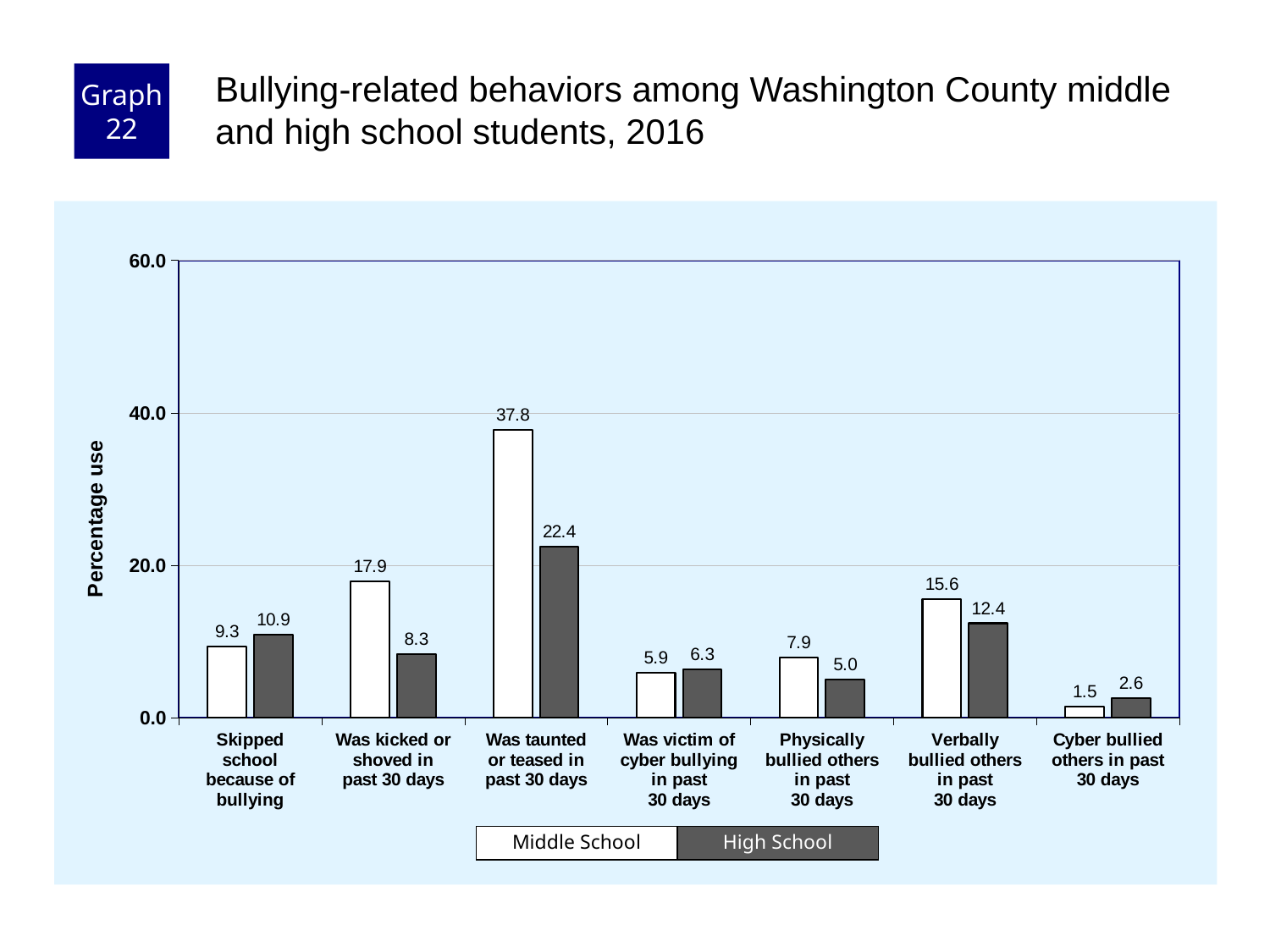
What is the High School value for 'Verbally bullied others in past 30 days'? 12.4 What is the Middle School value for 'Was taunted or teased in past 30 days'? 37.8 What is the difference between the Middle School and High School values for 'Was kicked or shoved in past 30 days'? 9.6 For 'Physically bullied others in past 30 days', which is larger: the Middle School or High School value? Middle School How many series does the legend list? 2 Which category has the highest Middle School value? Was taunted or teased in past 30 days Is the Middle School value for 'Was taunted or teased in past 30 days' greater or less than 40.0? less How many behavior categories are shown on the x axis? 7 What type of chart is shown on the slide? Bar chart What is the difference between the Middle School and High School values for 'Was taunted or teased in past 30 days'? 15.4 Which category has the lowest High School value? Cyber bullied others in past 30 days What is the High School value for 'Skipped school because of bullying'? 10.9